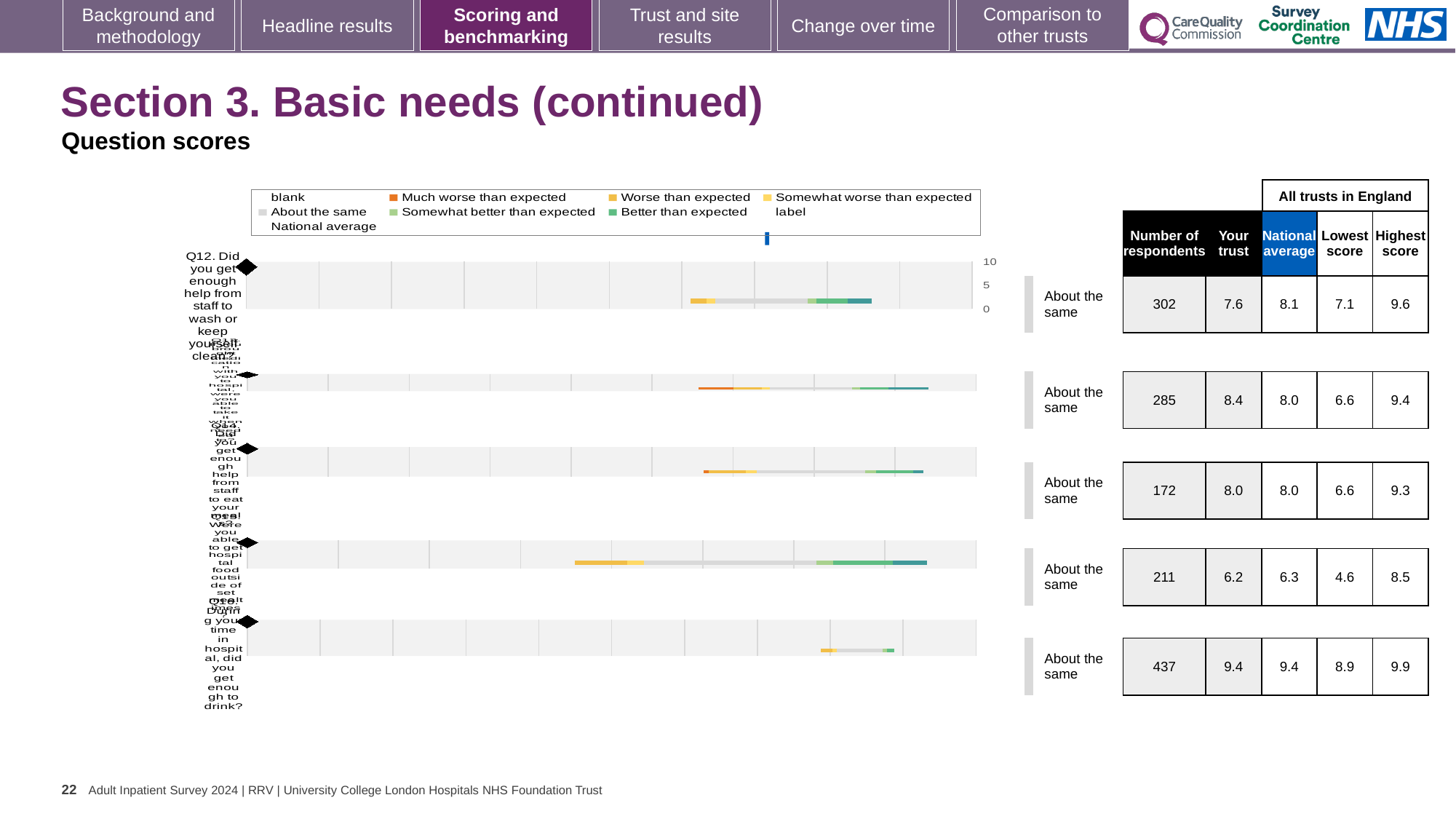
What is the 'Your trust' score for Q12? 7.6 What benchmark category is shown for Q12? About the same What is the lowest 'Your trust' score shown among the five questions? 6.2 How many respondents answered Q12 (help from staff to wash or keep yourself clean)? 302 For Q12, what is the difference between the national average and the 'Your trust' score? 0.5 How many respondents answered Q14 (help from staff to eat your meals)? 172 How many questions are plotted in the chart? 5 What type of chart is used to show the question scores? Bar chart What is the highest score across all trusts in England for Q14? 9.3 What is the national average score for Q12? 8.1 For Q12, which is larger: the 'Your trust' score or the national average? National average Which of the five questions has the largest number of respondents? The bottom (fifth) question, with 437